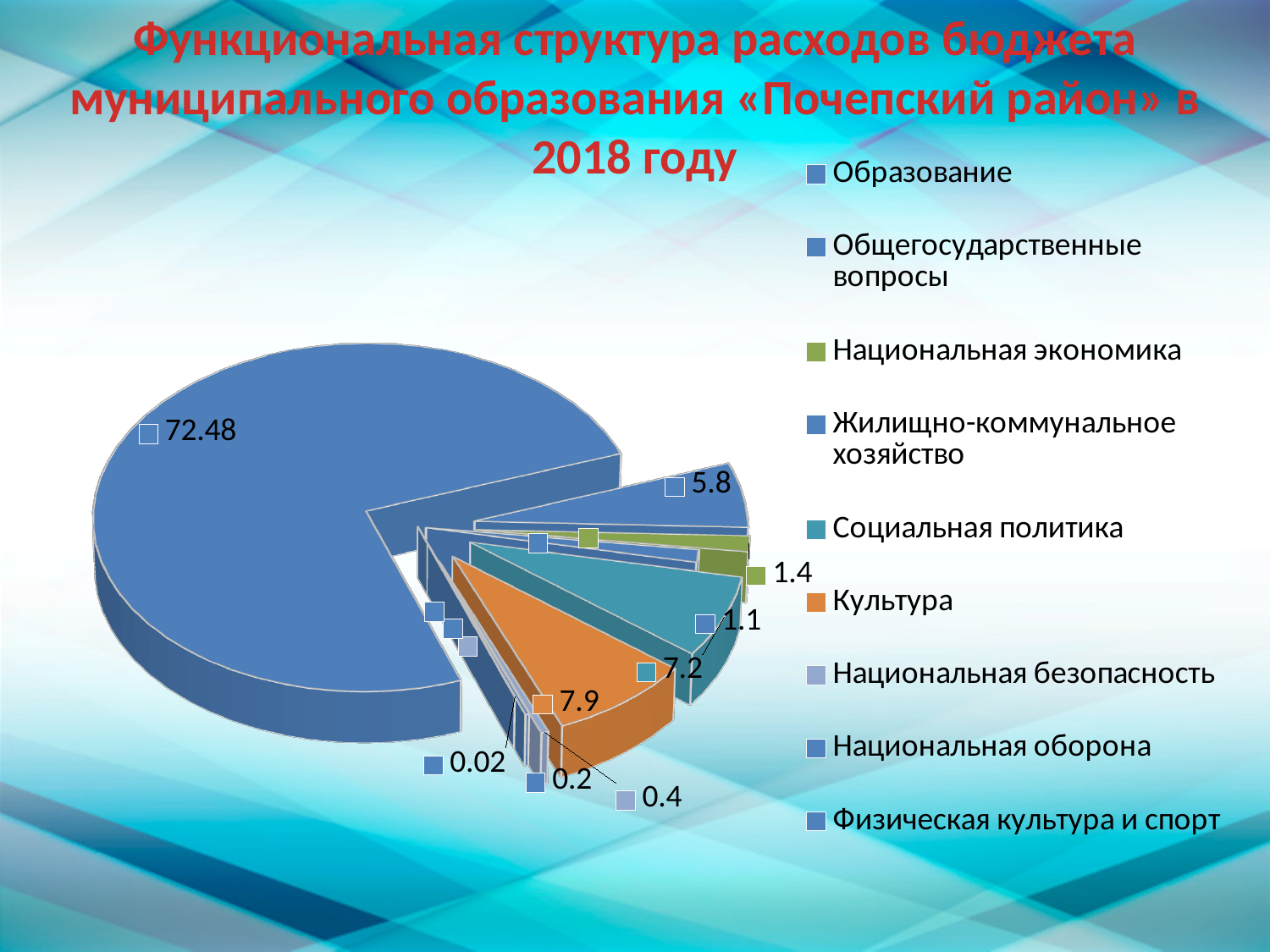
What is the value shown for Образование? 72.48 What is the value shown for Национальная экономика? 1.4 What is the difference between the values for Культура and Социальная политика? 0.7 What type of chart is shown on the slide? pie chart What is the value shown for Социальная политика? 7.2 Which is larger, the value for Культура or the value for Социальная политика? Культура How many categories does the legend of the pie chart list? 9 What is the smallest value labelled on the pie chart? 0.02 Which category has the largest slice of the pie? Образование Which year does the chart title say the budget expenditure structure refers to? 2018 What is the value shown for Общегосударственные вопросы? 5.8 What is the value shown for Культура? 7.9